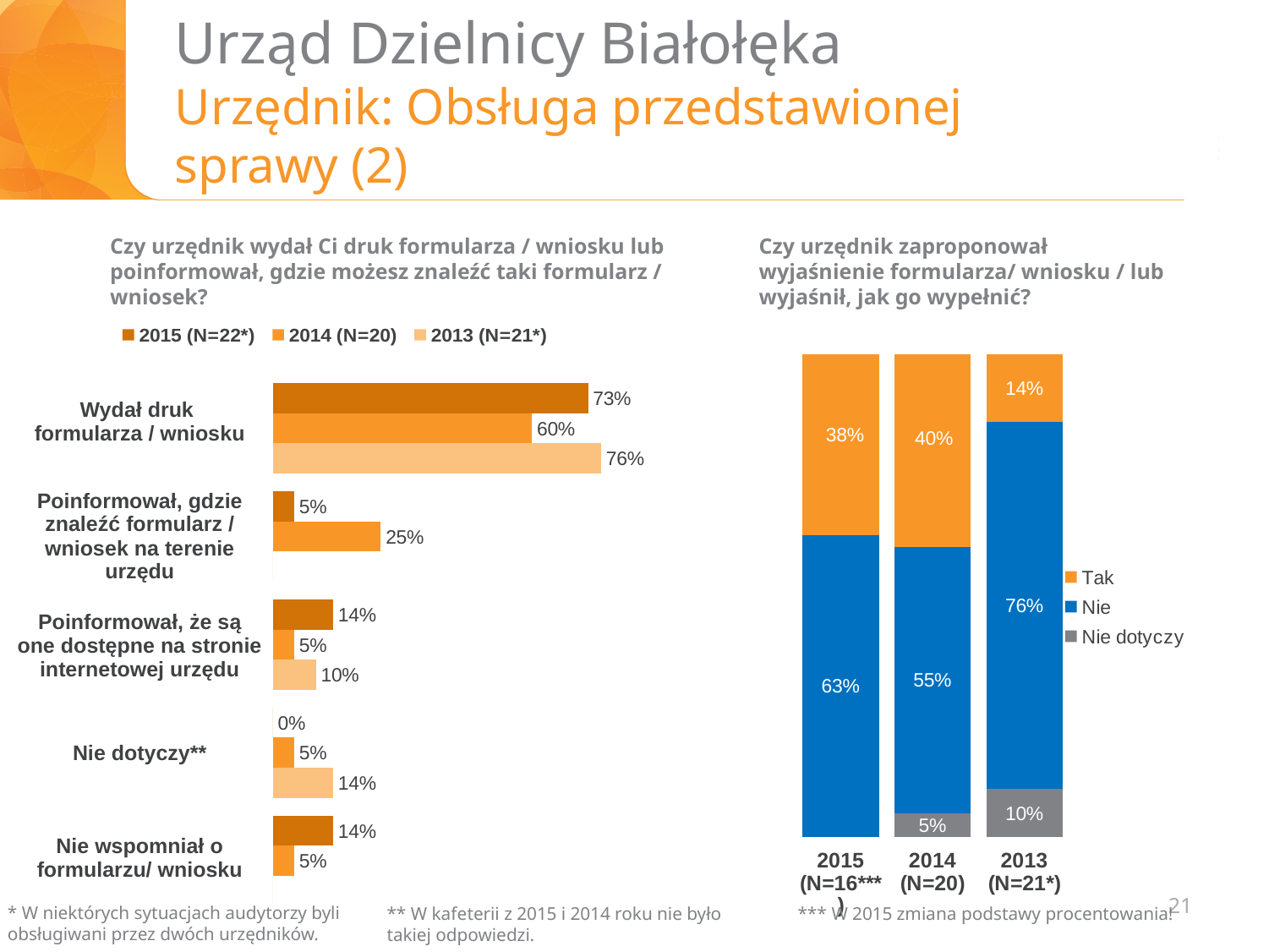
In the left chart, what is the 2015 value for 'Nie dotyczy**'? 0% In the left chart, what is the difference between the 2013 and 2014 values for 'Wydał druk formularza / wniosku'? 16 percentage points In the right chart, what is the 'Nie' share for 2013 (N=21*)? 76% In the left chart (Czy urzędnik wydał Ci druk formularza...), what is the 2015 value for 'Wydał druk formularza / wniosku'? 73% In the right chart, what is the 'Tak' share for 2014 (N=20)? 40% In the left chart, which year has the highest value for 'Wydał druk formularza / wniosku'? 2013 (N=21*) What type of chart is the right chart (Czy urzędnik zaproponował wyjaśnienie formularza...)? Stacked bar chart In the left chart, how many answer categories are shown on the vertical axis? 5 In the right chart, what is the difference between the 'Nie' shares for 2015 and 2014? 8 percentage points In the left chart, what is the 2014 value for 'Poinformował, gdzie znaleźć formularz / wniosek na terenie urzędu'? 25% In the right chart, which year has the lowest 'Tak' share? 2013 (N=21*) In the left chart, how many series does the legend list? 3